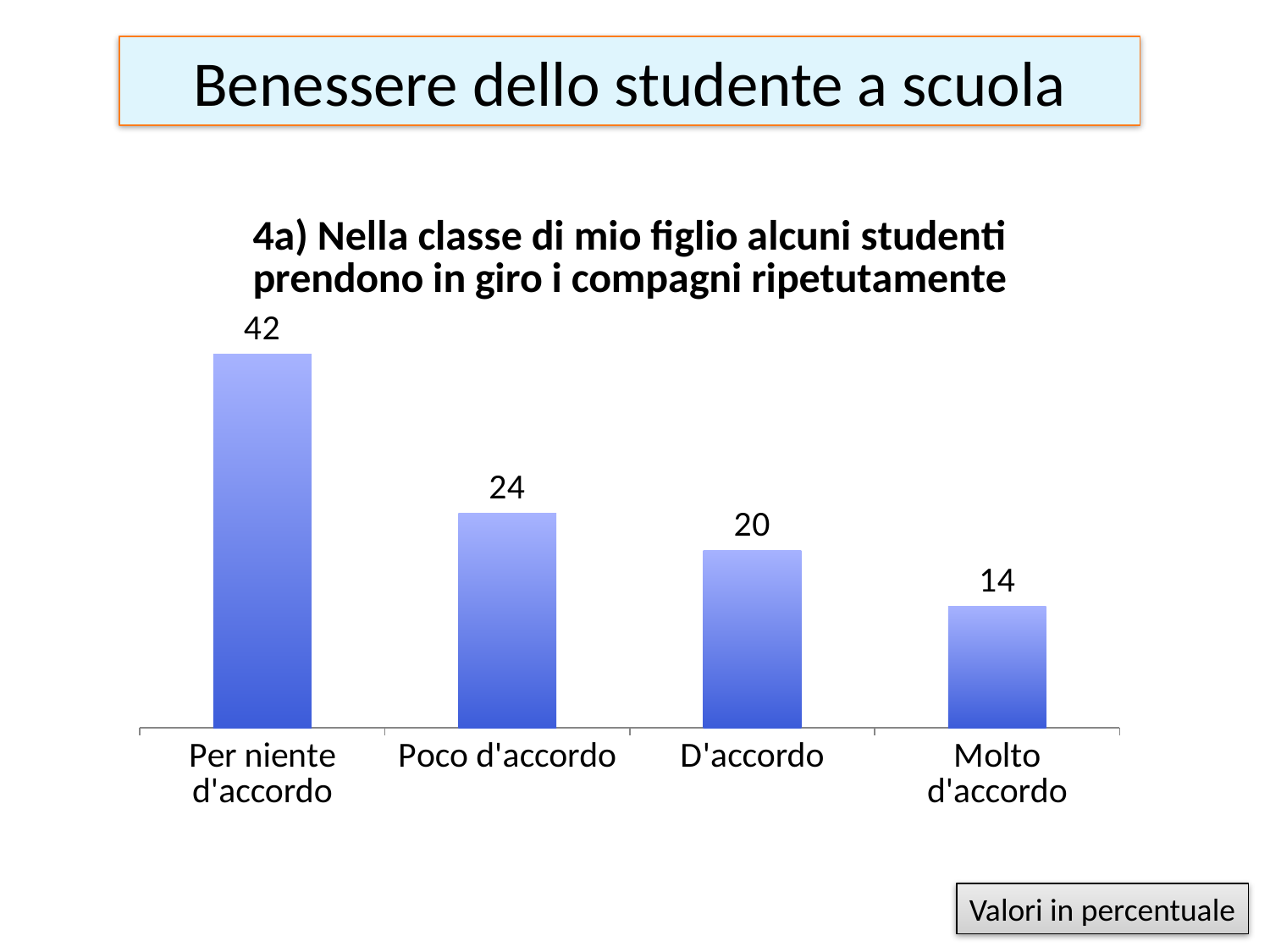
How many categories are shown on the chart? 4 What is the value for "D'accordo"? 20 Do the values rise or fall from left to right along the x axis? Fall What is the value for "Molto d'accordo"? 14 Which category has the lowest value? Molto d'accordo What is the difference between the values for "Per niente d'accordo" and "Poco d'accordo"? 18 What is the value for "Per niente d'accordo"? 42 What is the difference between the values for "D'accordo" and "Molto d'accordo"? 6 Which is larger, the value for "Poco d'accordo" or the value for "D'accordo"? Poco d'accordo What is the value for "Poco d'accordo"? 24 What kind of chart is shown on the slide? Bar chart Which category has the highest value? Per niente d'accordo